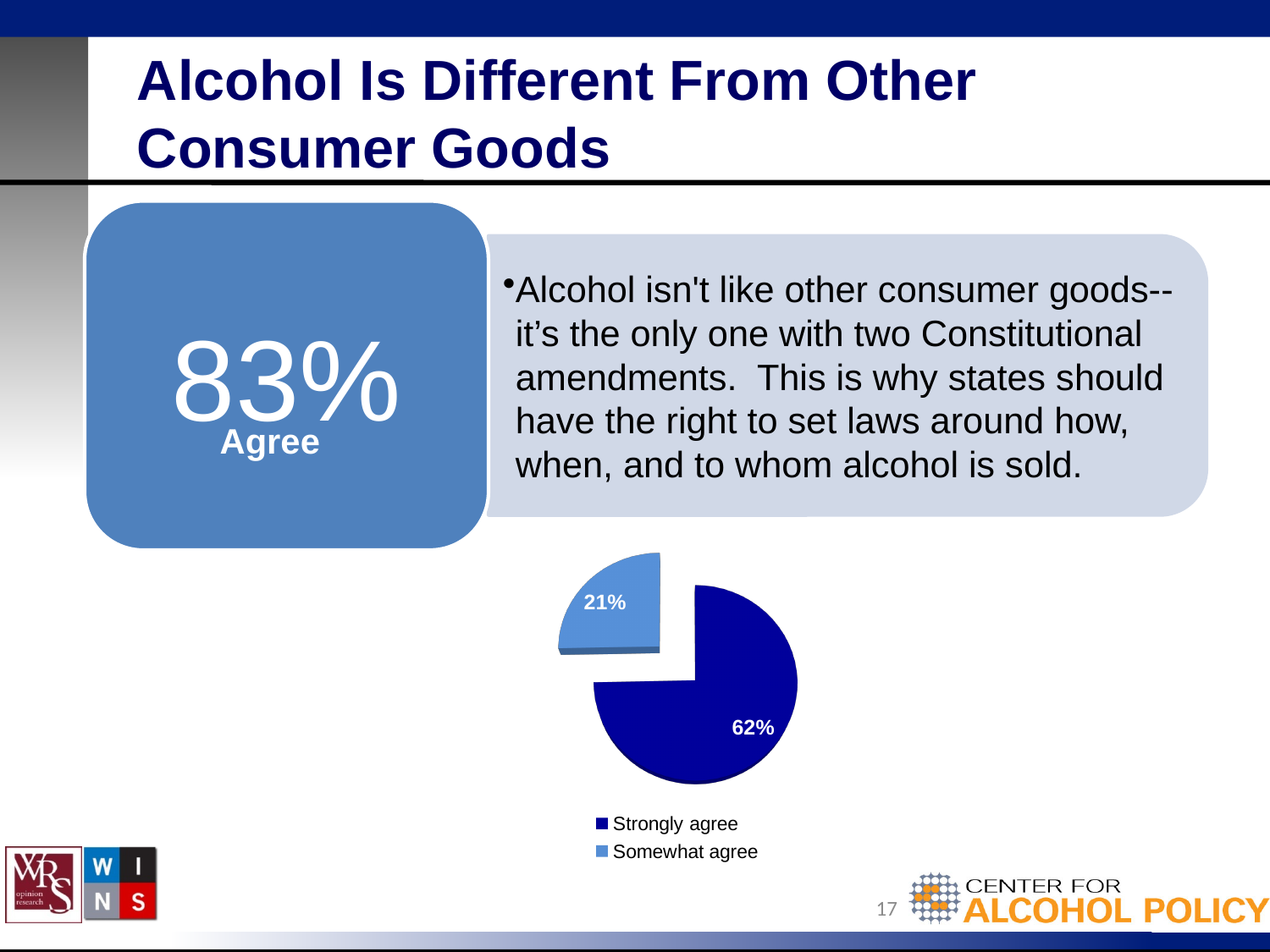
What kind of chart is shown on the slide? Pie chart How many entries does the pie chart's legend list? 2 Which is larger in the pie chart, "Strongly agree" or "Somewhat agree"? Strongly agree How many labelled slices does the pie chart have? 2 What is the combined value of the "Strongly agree" and "Somewhat agree" slices? 83% Which slice of the pie chart is the smallest? Somewhat agree Which slice of the pie chart is the largest? Strongly agree What colour is the "Somewhat agree" slice in the pie chart? Light blue What percentage of the pie chart is labelled "Strongly agree"? 62% What overall percentage is shown in the large blue box labelled "Agree"? 83% What percentage of the pie chart is labelled "Somewhat agree"? 21% What is the difference between the "Strongly agree" and "Somewhat agree" slices? 41%